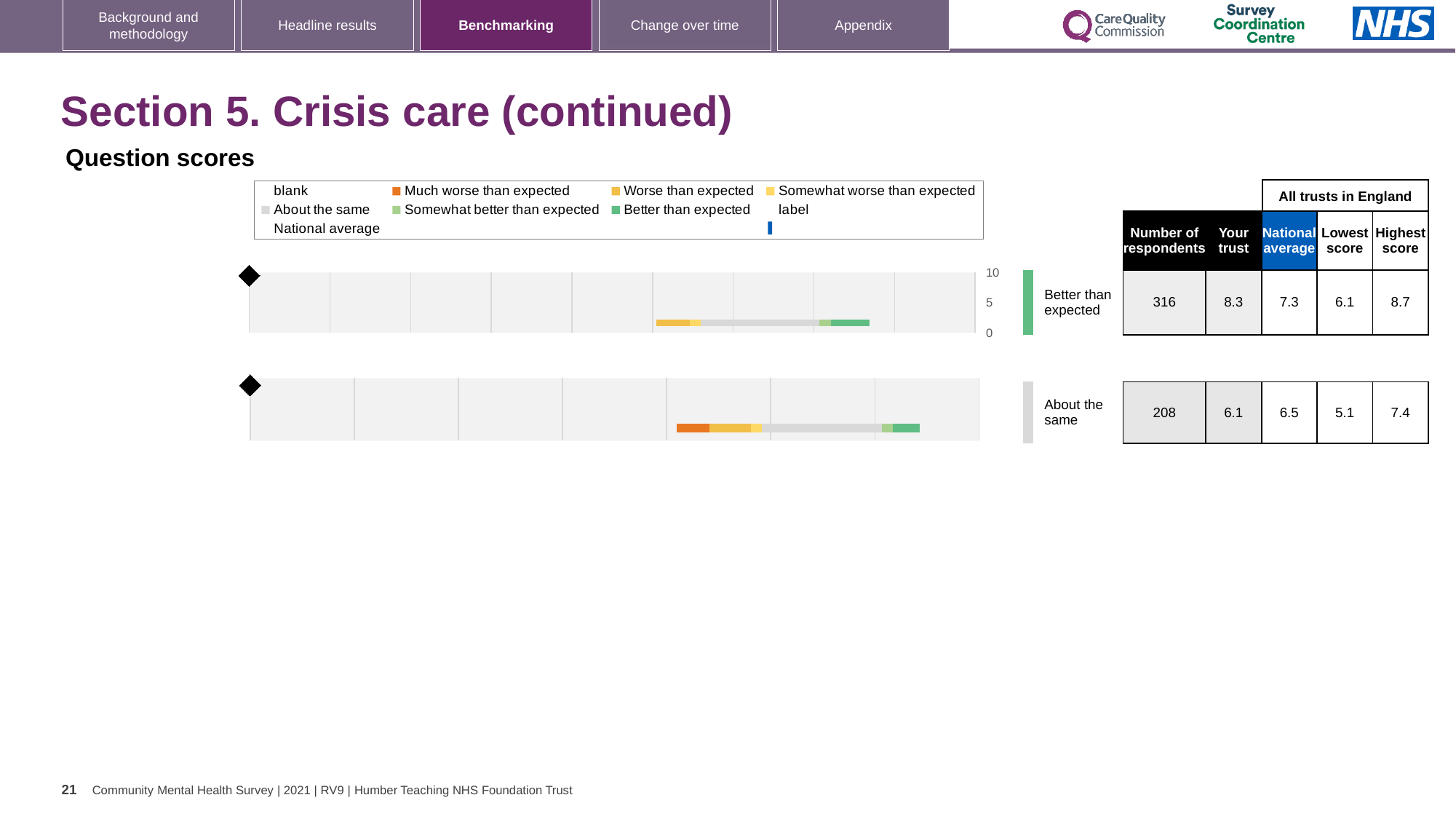
What is the benchmark rating label shown next to the bottom chart? About the same For the top chart, what is the difference between the highest score (8.7) and the lowest score (6.1)? 2.6 For the top chart, which is larger: the 'Your trust' score or the national average? Your trust For the top chart (rated 'Better than expected'), what is the national average? 7.3 For the top chart (rated 'Better than expected'), what is the 'Your trust' score? 8.3 What is the difference in number of respondents between the top chart (316) and the bottom chart (208)? 108 For the top chart (rated 'Better than expected'), what is the number of respondents? 316 How many question score charts (rows) are shown on the slide? 2 For the bottom chart (rated 'About the same'), what is the highest score among all trusts in England? 7.4 For the bottom chart (rated 'About the same'), what is the 'Your trust' score? 6.1 What kind of chart is used on this slide to show the question scores? bar chart For the bottom chart, which is larger: the 'Your trust' score or the national average? National average